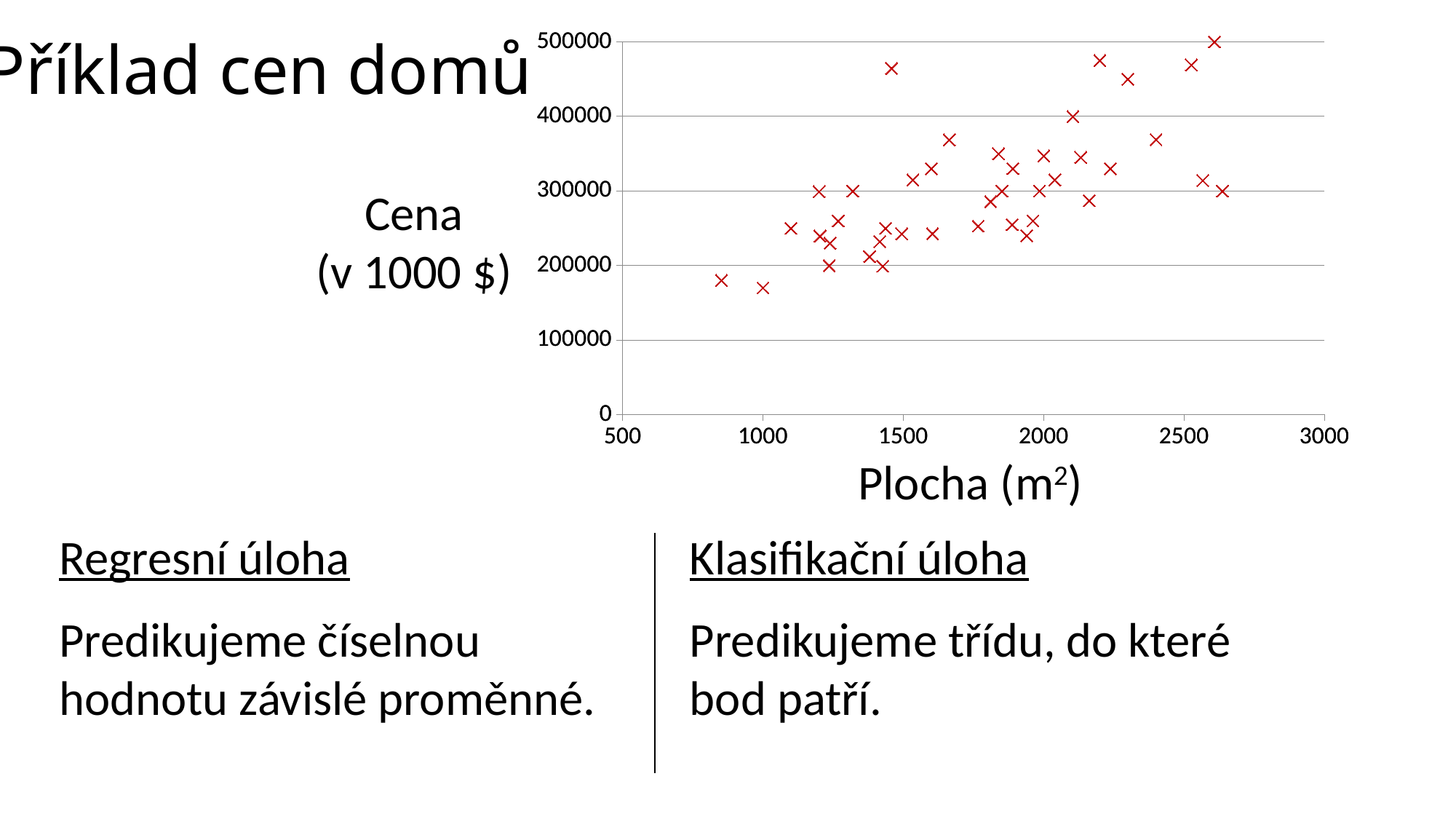
Is the highest price plotted on the chart greater or less than 400000? greater What is the label of the y axis of the chart? Cena (v 1000 $) Is the lowest price plotted on the chart greater or less than 200000? less As the area (Plocha) increases along the x axis, do the prices generally rise or fall? rise Is the price of the point with the smallest area (around 850 m²) greater or less than 200000? less What is the maximum value shown on the x axis of the chart? 3000 What kind of chart is shown on the slide? scatter plot What is the maximum value shown on the y axis of the chart? 500000 What is the minimum value shown on the x axis of the chart? 500 What is the label of the x axis of the chart? Plocha (m²)